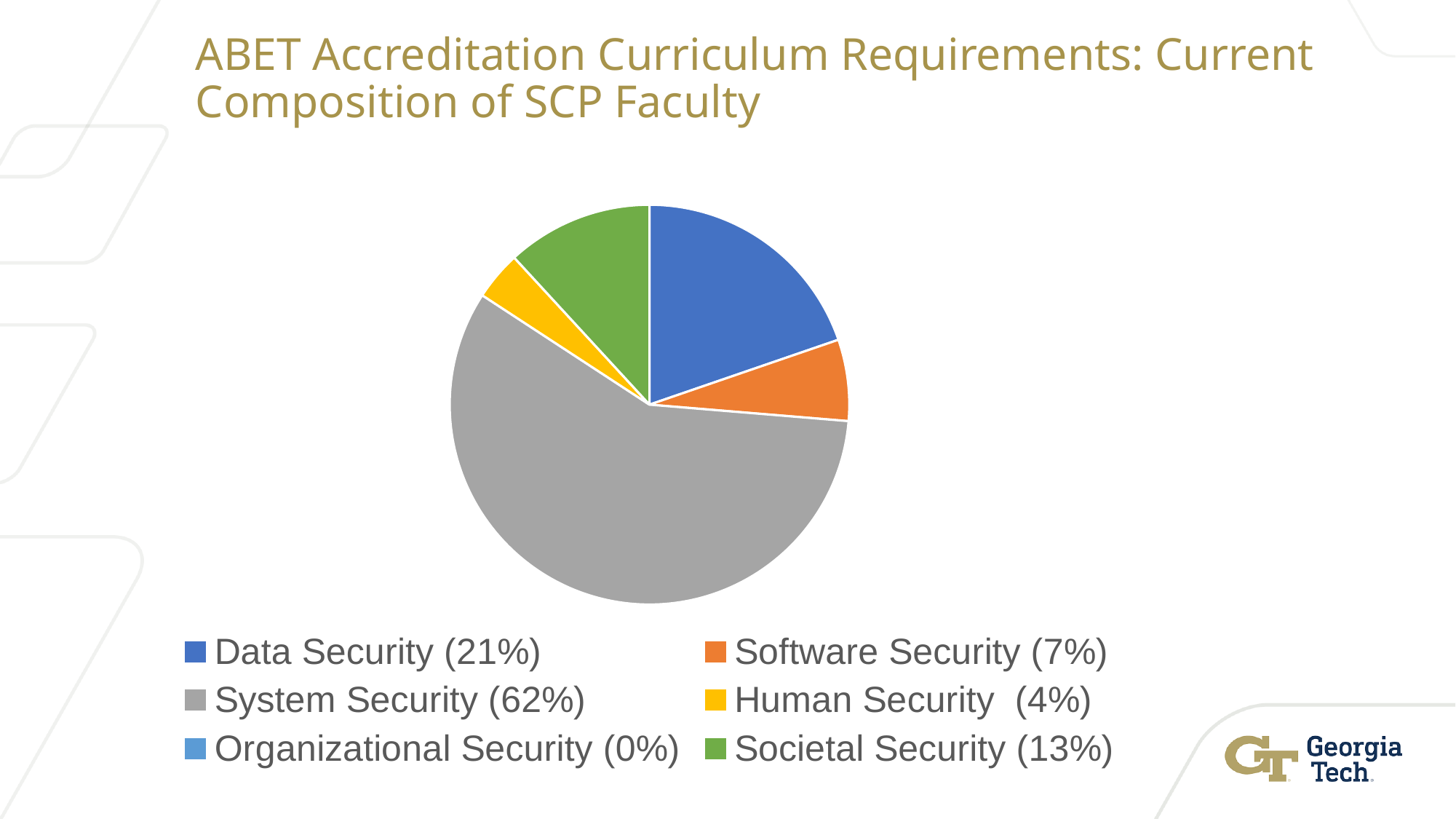
What percentage is shown for Societal Security? 13% What percentage is shown for Organizational Security? 0% What share of the pie does System Security represent? 62% What share of the pie does Data Security represent? 21% Which category has the largest share of the pie? System Security Which category has the smallest share of the pie? Organizational Security What colour is the System Security slice? grey Which is larger, Software Security or Societal Security? Societal Security What percentage is shown for Human Security? 4% What is the difference in percentage points between System Security and Data Security? 41 What kind of chart is shown on the slide? pie chart How many categories does the legend list? 6